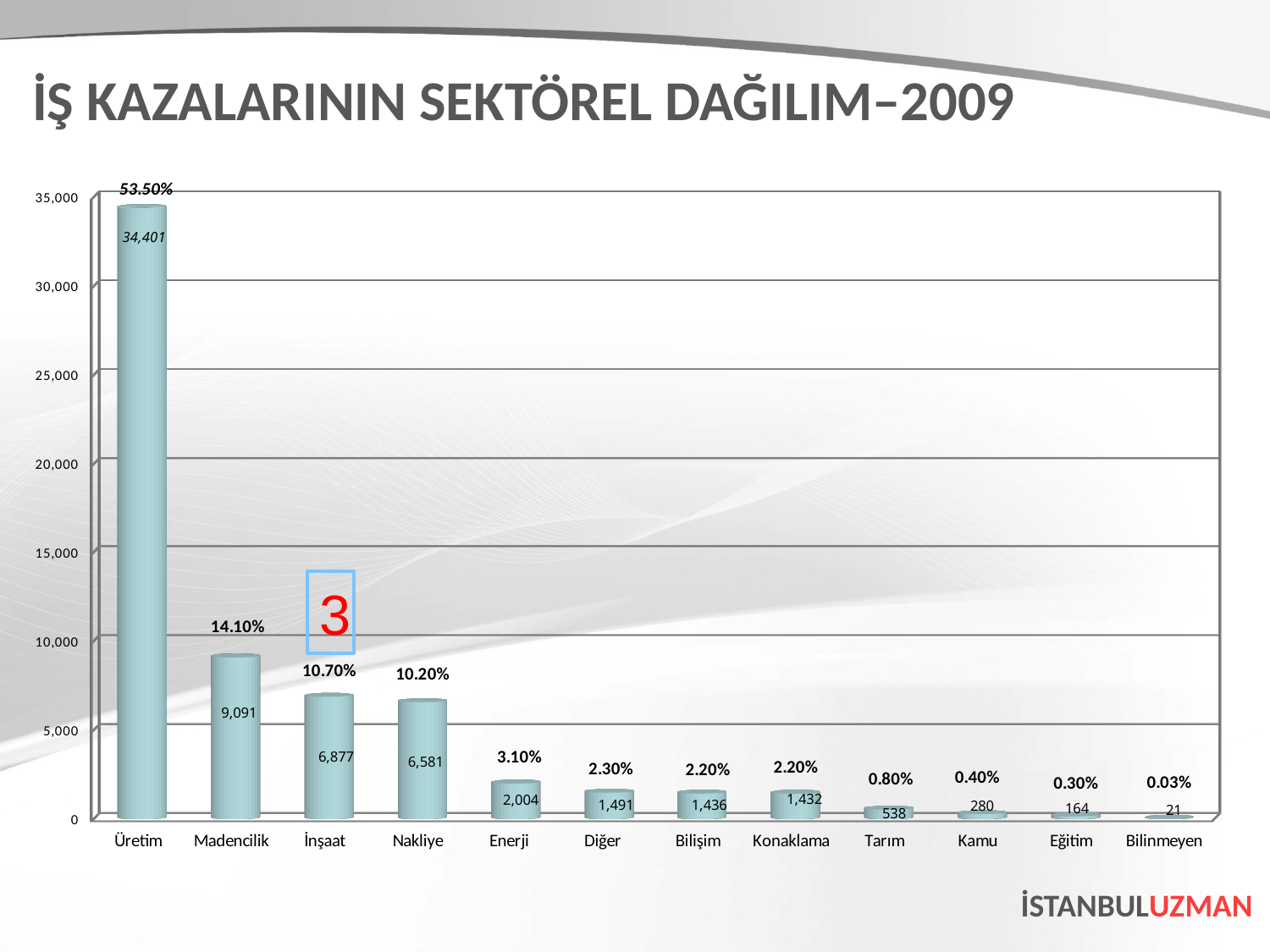
What is the value for Üretim? 34,401 What is the value for Bilinmeyen? 21 Which is larger, the value for Enerji or the value for Diğer? Enerji What kind of chart is shown on the slide? bar chart What is the difference between the values for İnşaat and Nakliye? 296 What is the title of the slide? İŞ KAZALARININ SEKTÖREL DAĞILIM–2009 Which category has the lowest value? Bilinmeyen What percentage is shown above the İnşaat bar? 10.70% Is the value for Madencilik greater or less than 10,000? less What is the value for Madencilik? 9,091 How many categories are shown on the x axis? 12 Which category has the highest value? Üretim